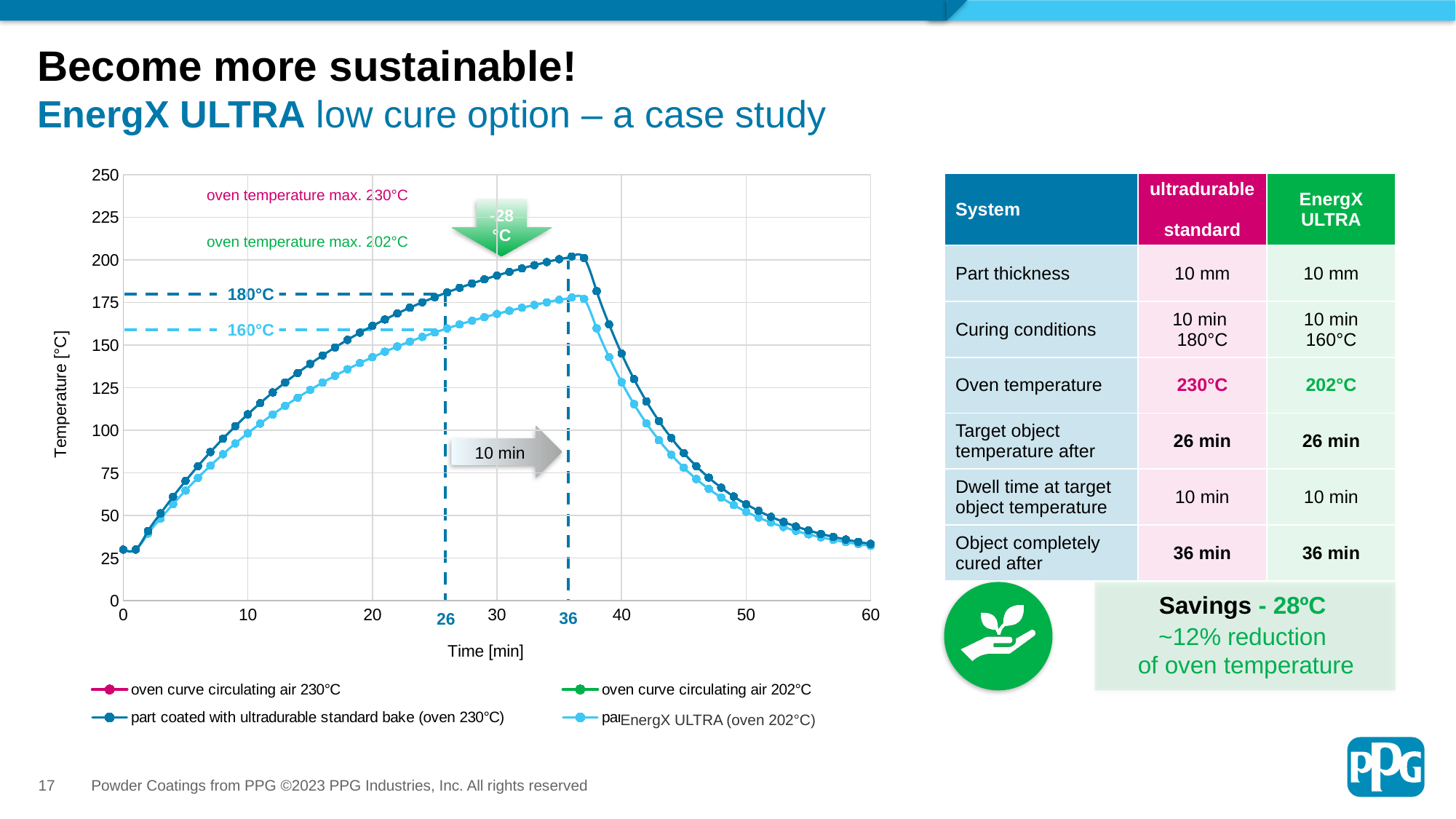
What is the label of the chart's horizontal axis? Time [min] What is the difference between the annotated target temperatures of 180°C and 160°C on the chart? 20°C What dwell time is indicated by the grey arrow between the 26 min and 36 min markers? 10 min What is the label of the chart's vertical axis? Temperature [°C] Between 36 min and 60 min, do the part temperature curves rise or fall? fall According to the dashed annotation, what temperature does the part coated with ultradurable standard bake reach at 26 min? 180°C Is the temperature of the part coated with ultradurable standard bake at 20 min greater or less than 125? greater Is the temperature of the part coated with EnergX ULTRA at 50 min greater or less than 75? less According to the dashed annotation, what temperature does the part coated with EnergX ULTRA reach at 26 min? 160°C How many series does the chart's legend list? 4 At 30 min, which curve is higher: the part coated with ultradurable standard bake or the part coated with EnergX ULTRA? part coated with ultradurable standard bake What kind of chart is shown on the slide? line chart